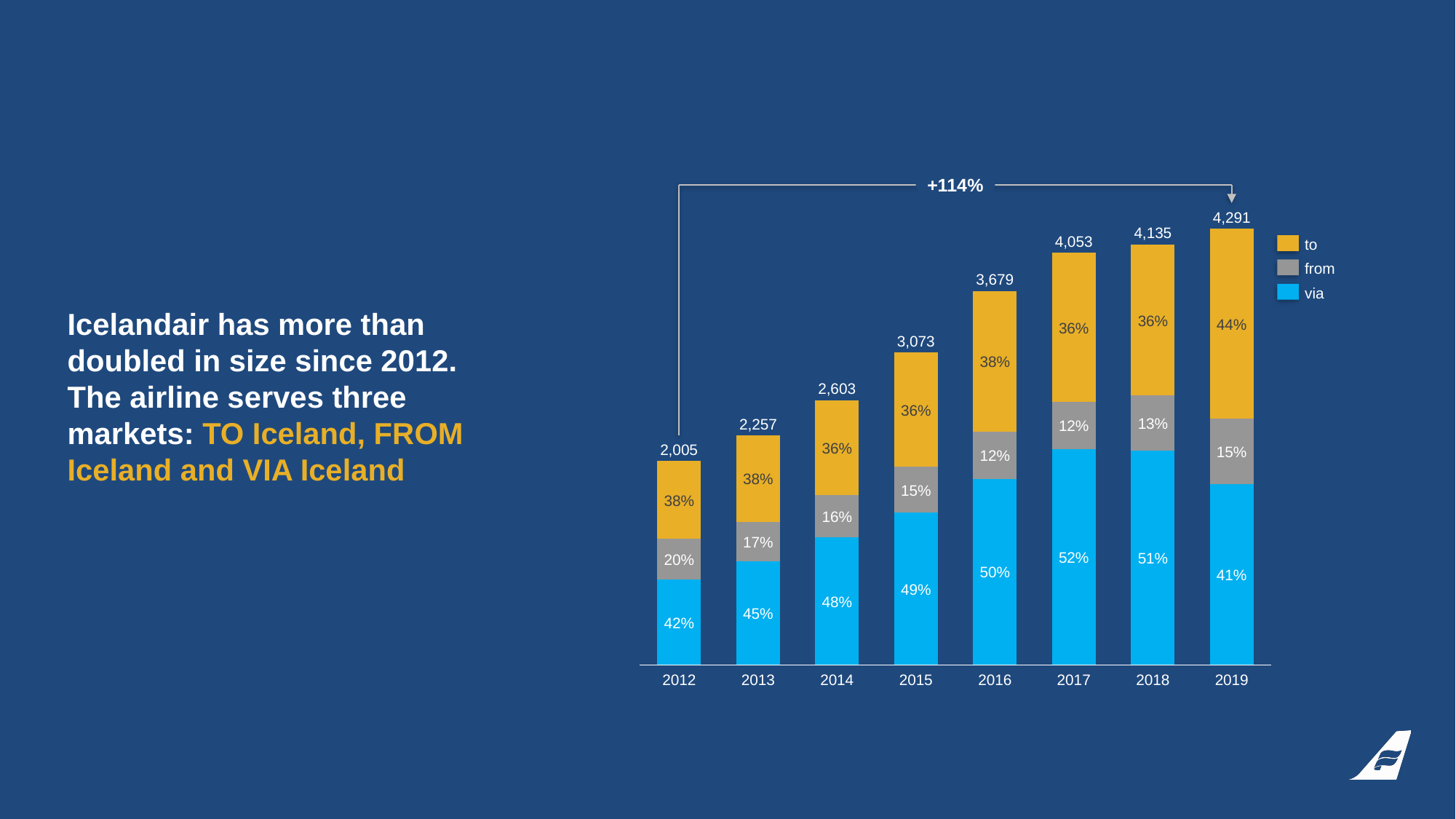
What is the difference between the total values for 2019 and 2012? 2,286 What kind of chart is shown on the slide? Stacked bar chart What is the total value shown above the bar for 2012? 2,005 What percentage share does the 'from' segment have in 2013? 17% How many years are shown on the x axis? 8 Which year has the lowest total value? 2012 What percentage share does the 'via' segment have in 2017? 52% Which year has the larger total value, 2016 or 2015? 2016 What percentage share does the 'to' segment have in 2019? 44% What is the total value shown above the bar for 2019? 4,291 How many series does the legend list? 3 Which year has the highest total value? 2019